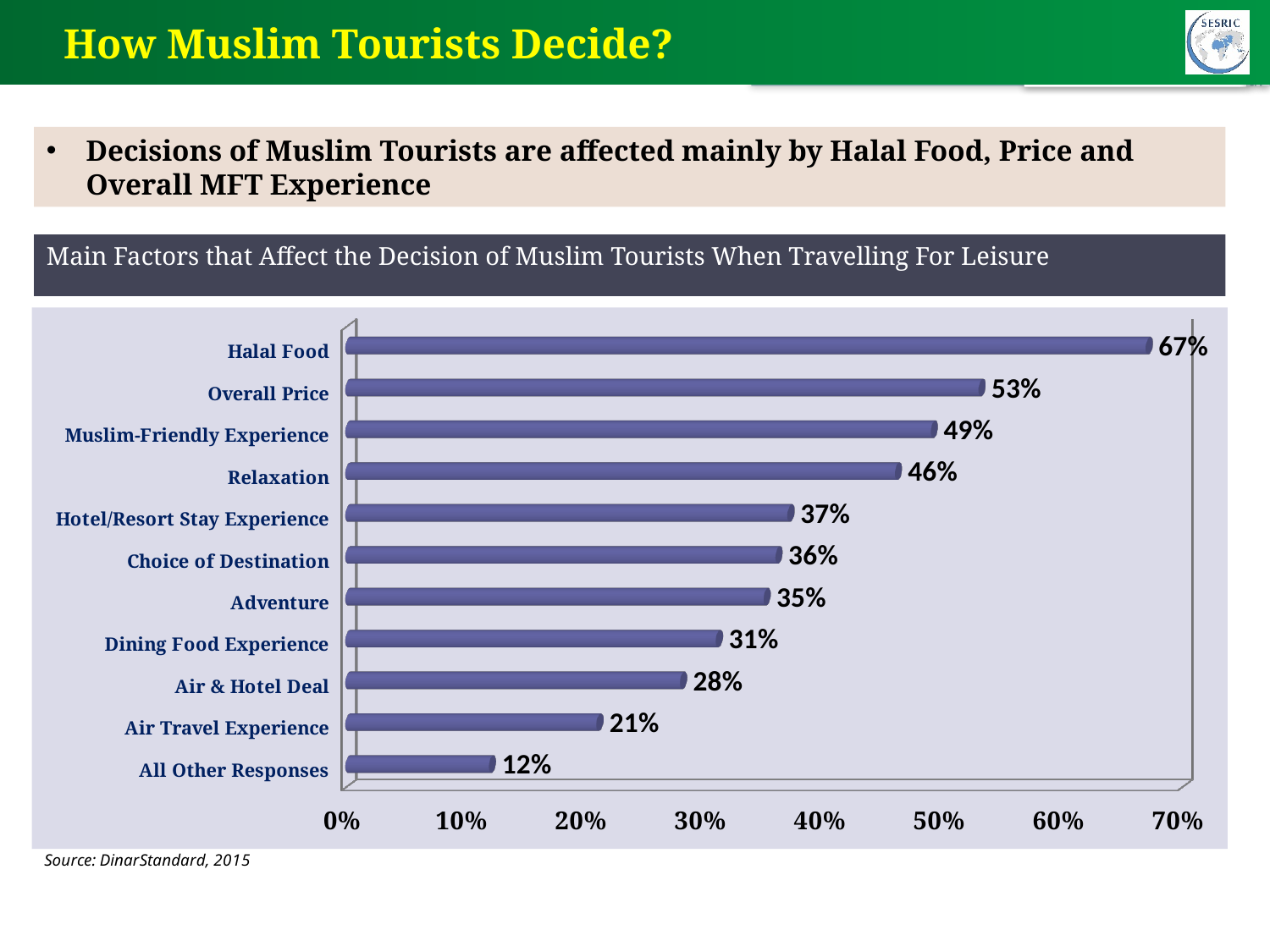
What is the title of the chart? Main Factors that Affect the Decision of Muslim Tourists When Travelling For Leisure Which factor has the highest value? Halal Food Is the value for Adventure greater or less than 30%? greater What is the value for Relaxation? 46% What percentage is shown for Air Travel Experience? 21% What percentage is shown for Halal Food? 67% Which category has the lowest value? All Other Responses How many categories are shown in the chart? 11 What is the difference between Dining Food Experience and Air & Hotel Deal? 3% What kind of chart is shown on the slide? Bar chart What is the difference between the values for Halal Food and Overall Price? 14% Which is larger, Muslim-Friendly Experience or Relaxation? Muslim-Friendly Experience